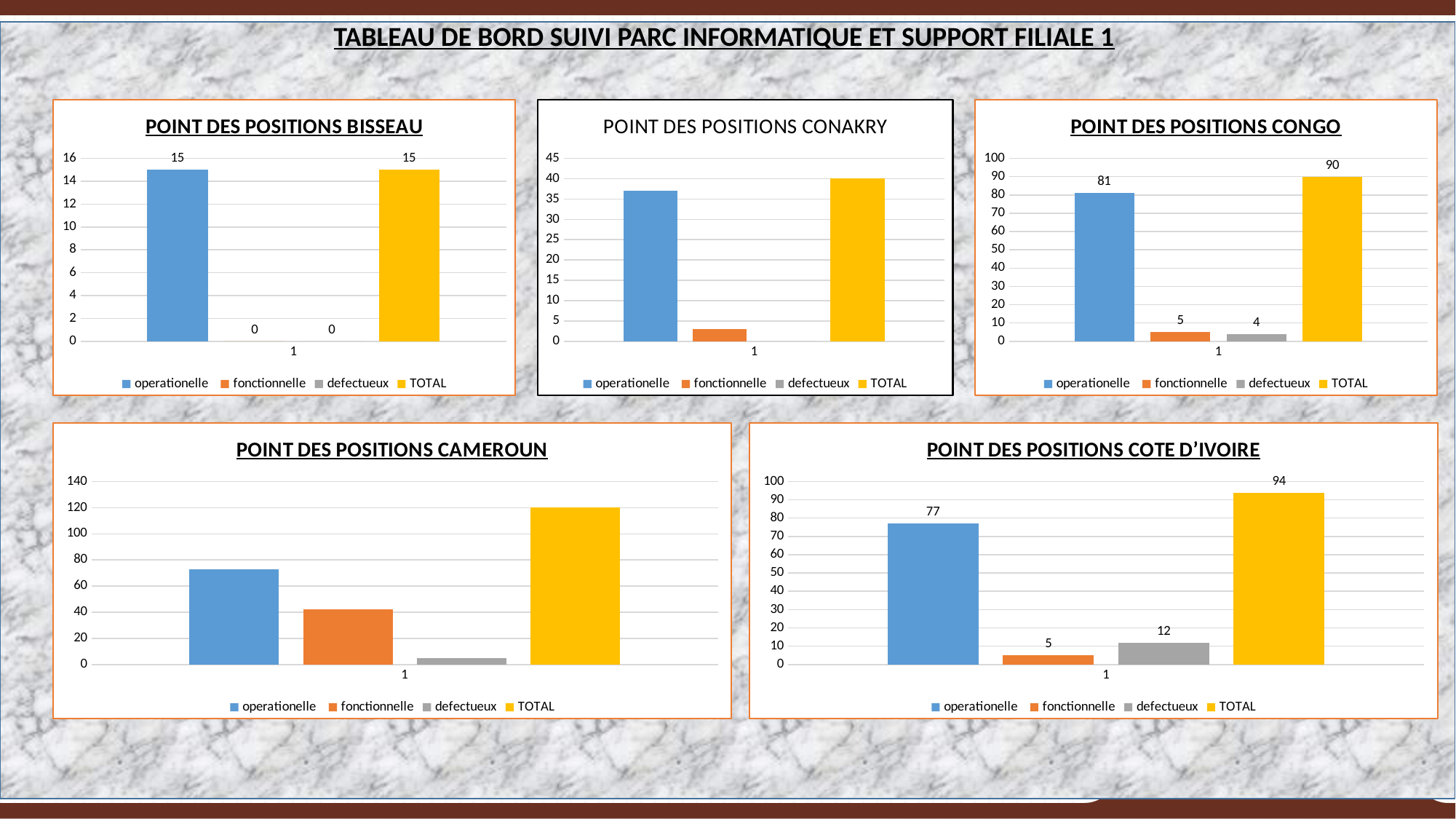
How many series does the legend of the POINT DES POSITIONS CAMEROUN chart list? 4 In the POINT DES POSITIONS COTE D'IVOIRE chart, what is the difference between operationelle and defectueux? 65 In the POINT DES POSITIONS CONAKRY chart, is the value for operationelle greater or less than 35? greater In the POINT DES POSITIONS CONGO chart, what is the value for operationelle? 81 In the POINT DES POSITIONS CONGO chart, which series has the lowest value? defectueux What kind of chart is the POINT DES POSITIONS CONAKRY chart? bar chart In the POINT DES POSITIONS COTE D'IVOIRE chart, what is the value for defectueux? 12 In the POINT DES POSITIONS CAMEROUN chart, is the value for defectueux greater or less than 20? less In the POINT DES POSITIONS CAMEROUN chart, is the value for operationelle greater or less than 60? greater In the POINT DES POSITIONS CONGO chart, what is the difference between TOTAL and operationelle? 9 Which is larger: defectueux in the POINT DES POSITIONS COTE D'IVOIRE chart or defectueux in the POINT DES POSITIONS CONGO chart? COTE D'IVOIRE In the POINT DES POSITIONS BISSEAU chart, what is the value for TOTAL? 15